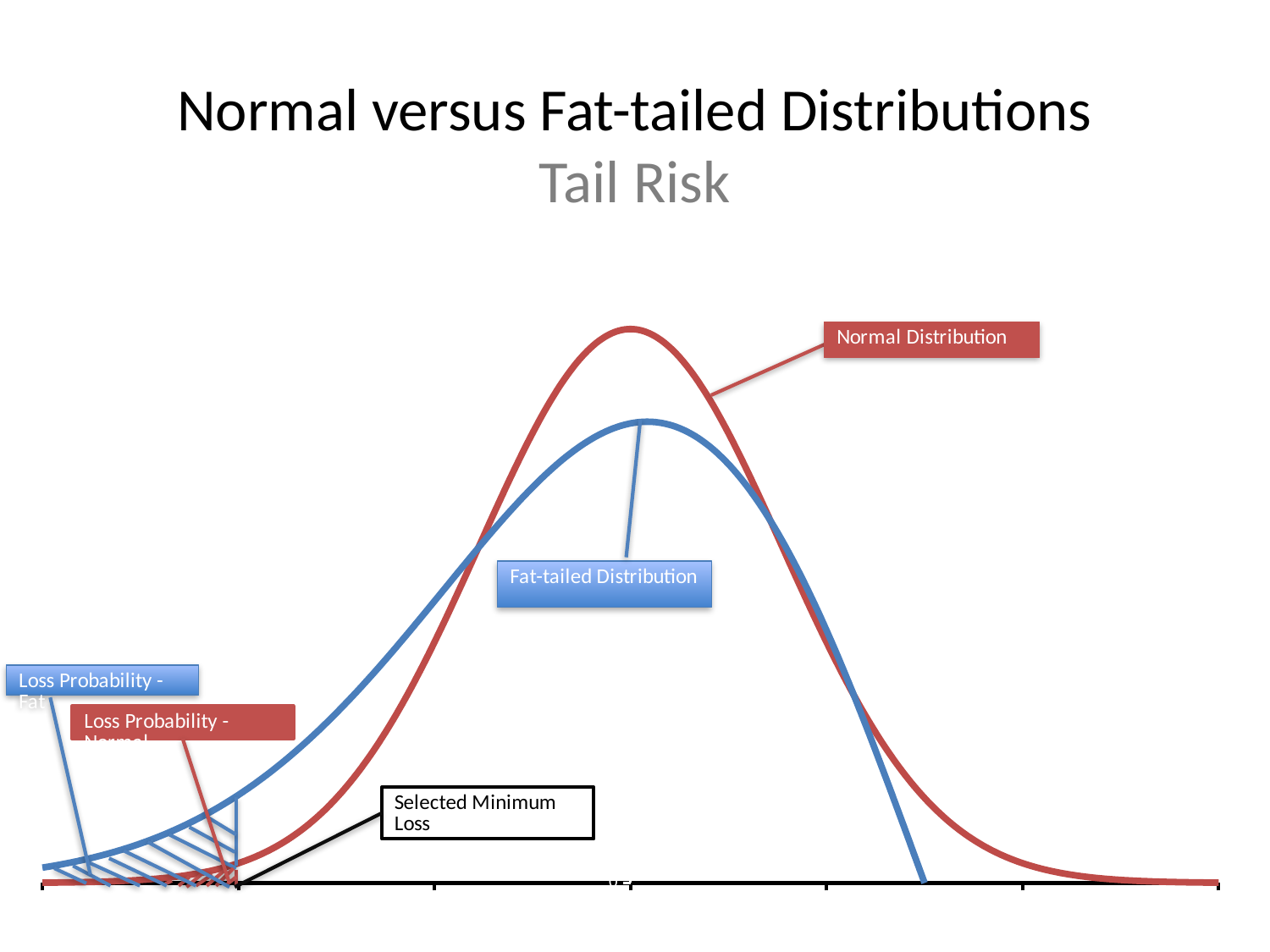
What colour is the Fat-tailed Distribution curve? blue How many distribution curves are plotted on the chart? 2 Does the Normal Distribution curve rise or fall to the right of its peak? fall What is the title of the chart on the slide? Normal versus Fat-tailed Distributions Which distribution has the larger shaded loss probability area to the left of the Selected Minimum Loss, Normal or Fat-tailed? Fat-tailed Which distribution curve has the lower peak? Fat-tailed Distribution What kind of chart is shown on the slide? line chart What colour is the Normal Distribution curve? red Which curve reaches the higher peak, the Normal Distribution or the Fat-tailed Distribution? Normal Distribution Does the Fat-tailed Distribution curve rise or fall from the left edge of the chart up to its peak? rise